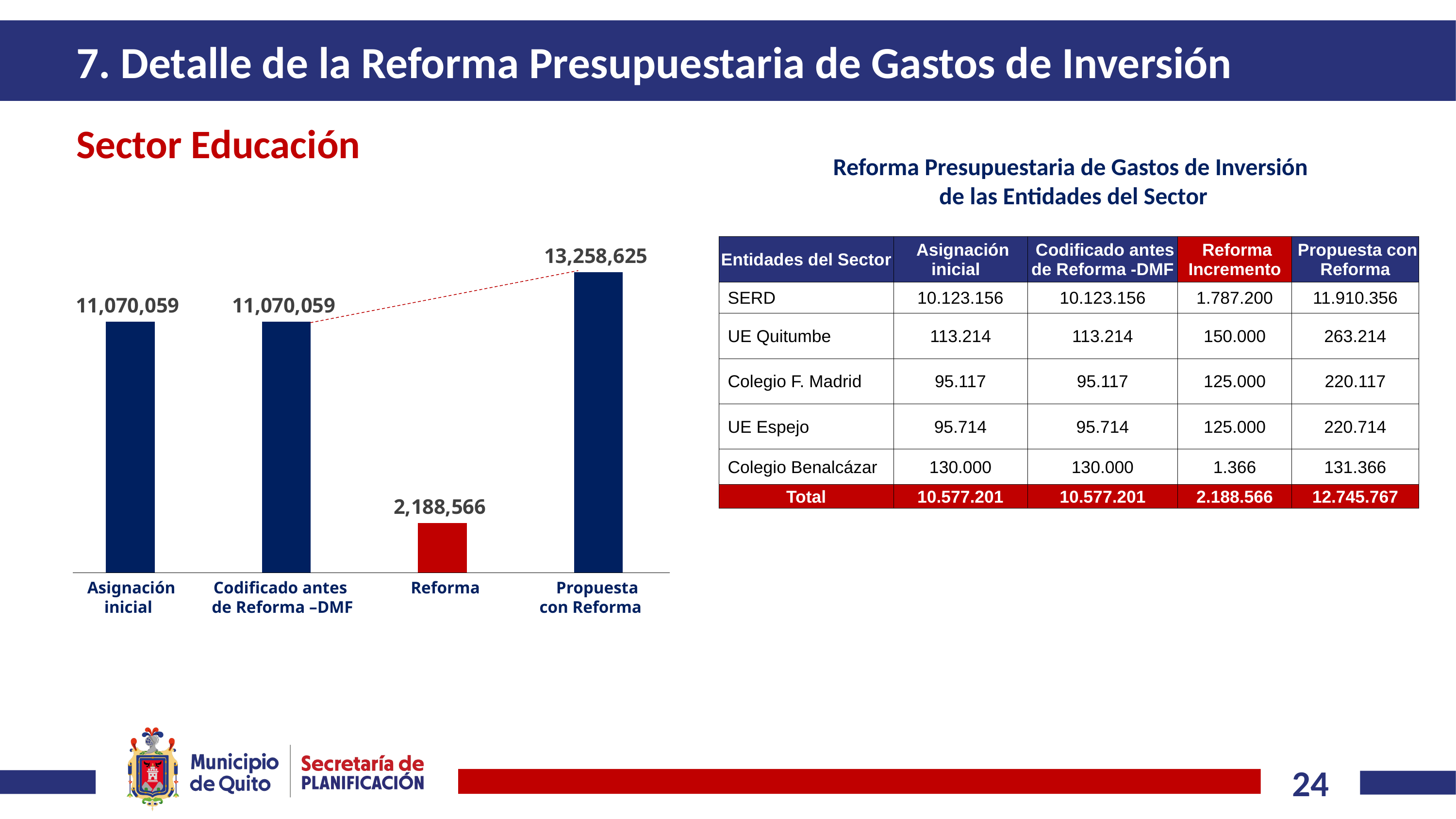
Which category has the lowest value in the bar chart? Reforma Which category has the highest value in the bar chart? Propuesta con Reforma What is the value shown for Codificado antes de Reforma –DMF in the bar chart? 11,070,059 Which is larger in the bar chart, the value for Reforma or the value for Asignación inicial? Asignación inicial What is the difference between the values for Propuesta con Reforma and Codificado antes de Reforma –DMF in the bar chart? 2,188,566 How many categories are shown in the bar chart? 4 Which bar in the chart is coloured red? Reforma What is the value shown for Propuesta con Reforma in the bar chart? 13,258,625 What is the value shown for Reforma in the bar chart? 2,188,566 What kind of chart is shown on the slide? Bar chart What is the value shown for Asignación inicial in the bar chart? 11,070,059 What is the difference between the values for Asignación inicial and Reforma in the bar chart? 8,881,493